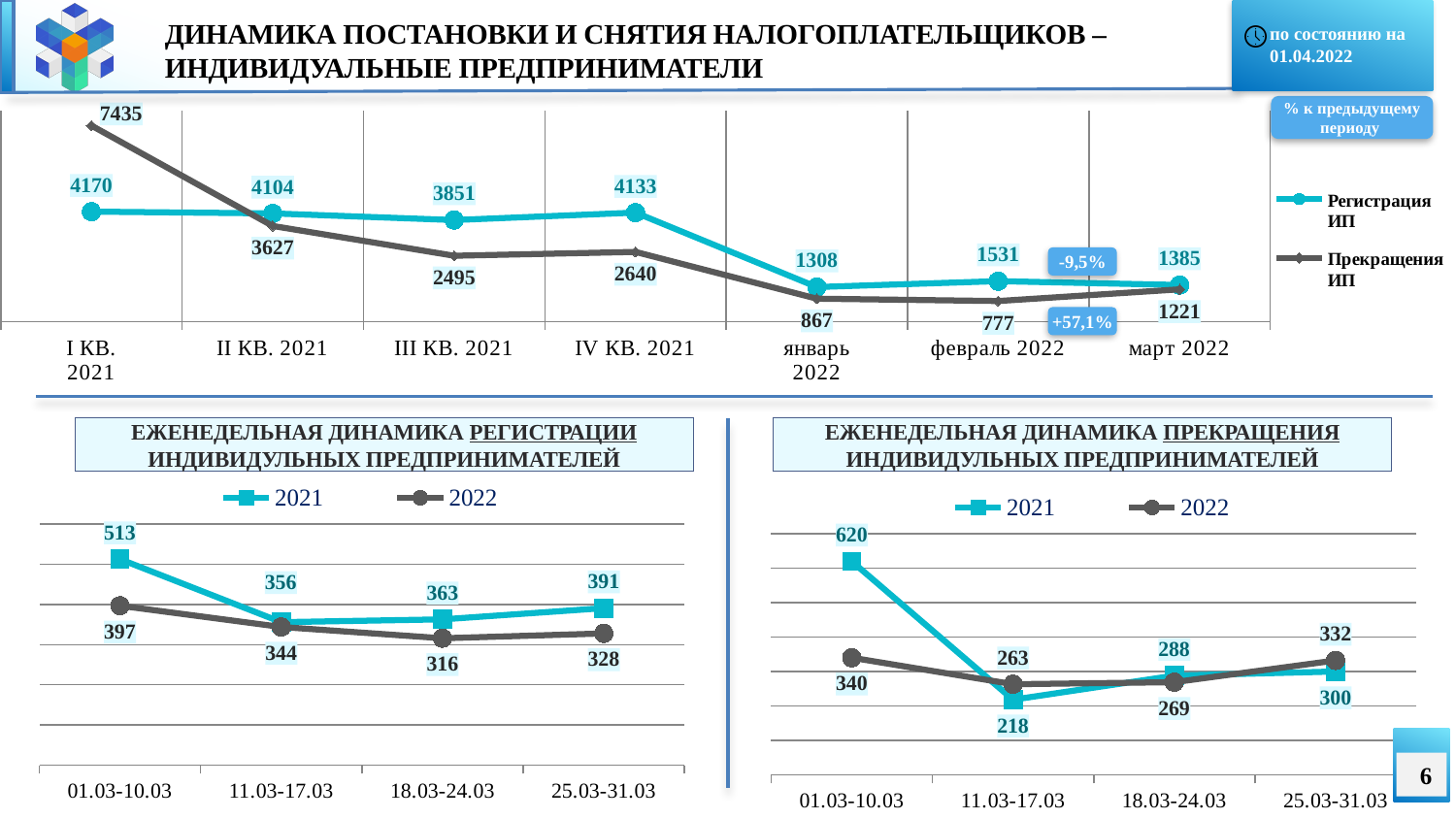
In the bottom-left chart, which week has the highest 2021 value? 01.03-10.03 In the bottom-right chart (ЕЖЕНЕДЕЛЬНАЯ ДИНАМИКА ПРЕКРАЩЕНИЯ), what is the 2021 value for 11.03-17.03? 218 In the top chart, what is the difference between Регистрация ИП and Прекращения ИП for март 2022? 164 What type of chart is the bottom-right chart? line chart In the bottom-left chart, what is the difference between the 2021 and 2022 values for 01.03-10.03? 116 In the top chart (ДИНАМИКА ПОСТАНОВКИ И СНЯТИЯ НАЛОГОПЛАТЕЛЬЩИКОВ), what is the value of Регистрация ИП for III КВ. 2021? 3851 In the bottom-left chart (ЕЖЕНЕДЕЛЬНАЯ ДИНАМИКА РЕГИСТРАЦИИ), what is the 2022 value for 18.03-24.03? 316 In the bottom-right chart, which is larger for 25.03-31.03: the 2021 value or the 2022 value? 2022 In the top chart, which period has the lowest value for Прекращения ИП? февраль 2022 In the top chart, how many series does the legend list? 2 In the top chart, how many periods are shown on the x axis? 7 In the top chart, what is the value of Прекращения ИП for I КВ. 2021? 7435